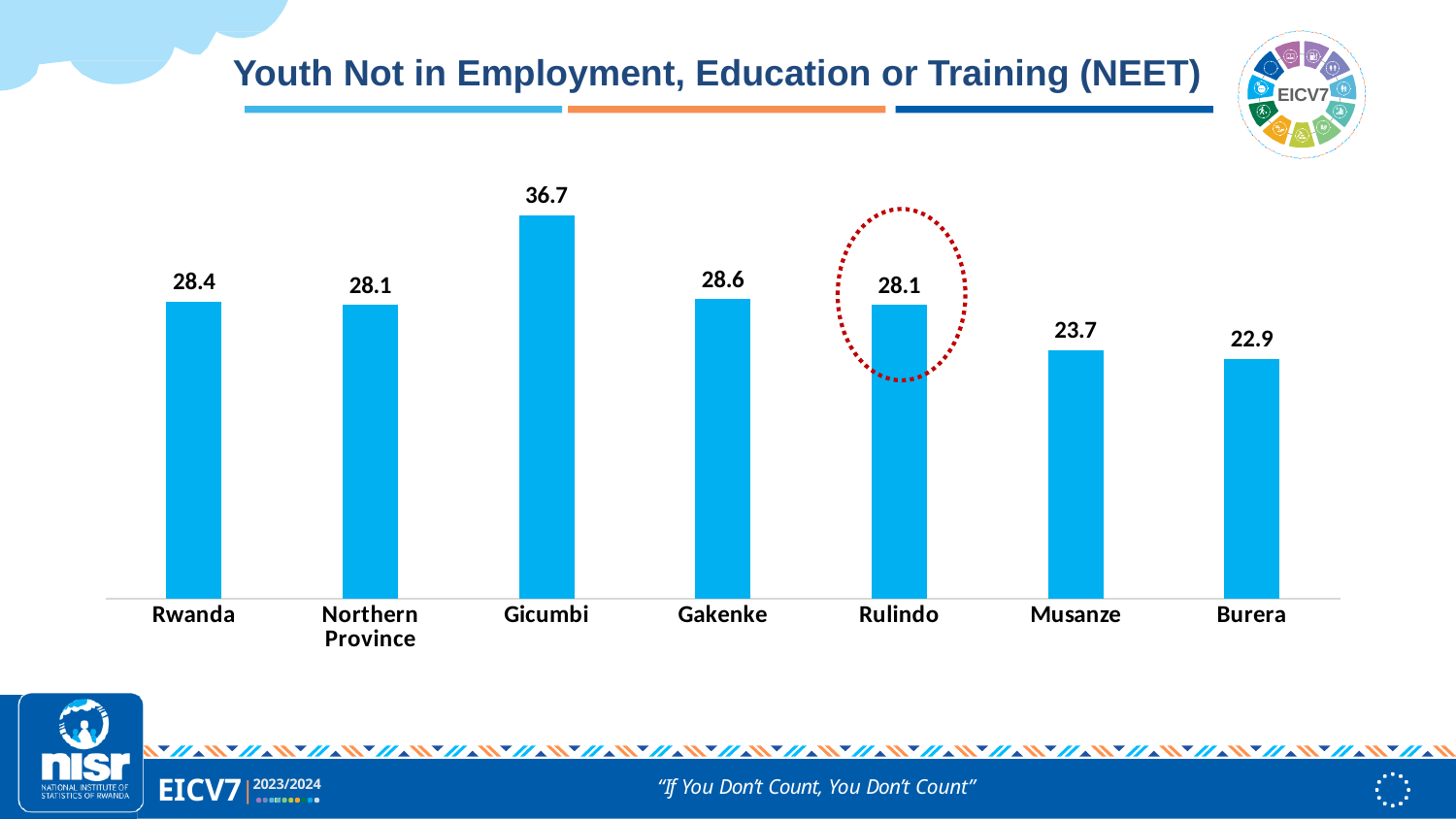
What is the difference between the values for Gicumbi and Musanze? 13.0 What is the value for Gicumbi? 36.7 Which category has the highest value? Gicumbi Which is larger, the value for Gakenke or the value for Musanze? Gakenke What is the value for Rulindo? 28.1 What is the difference between the values for Rwanda and Burera? 5.5 What is the value for Rwanda? 28.4 What kind of chart is shown on the slide? Bar chart Which category's bar is highlighted with a red dotted circle? Rulindo Which category has the lowest value? Burera How many categories are shown on the x axis? 7 What is the value for Burera? 22.9